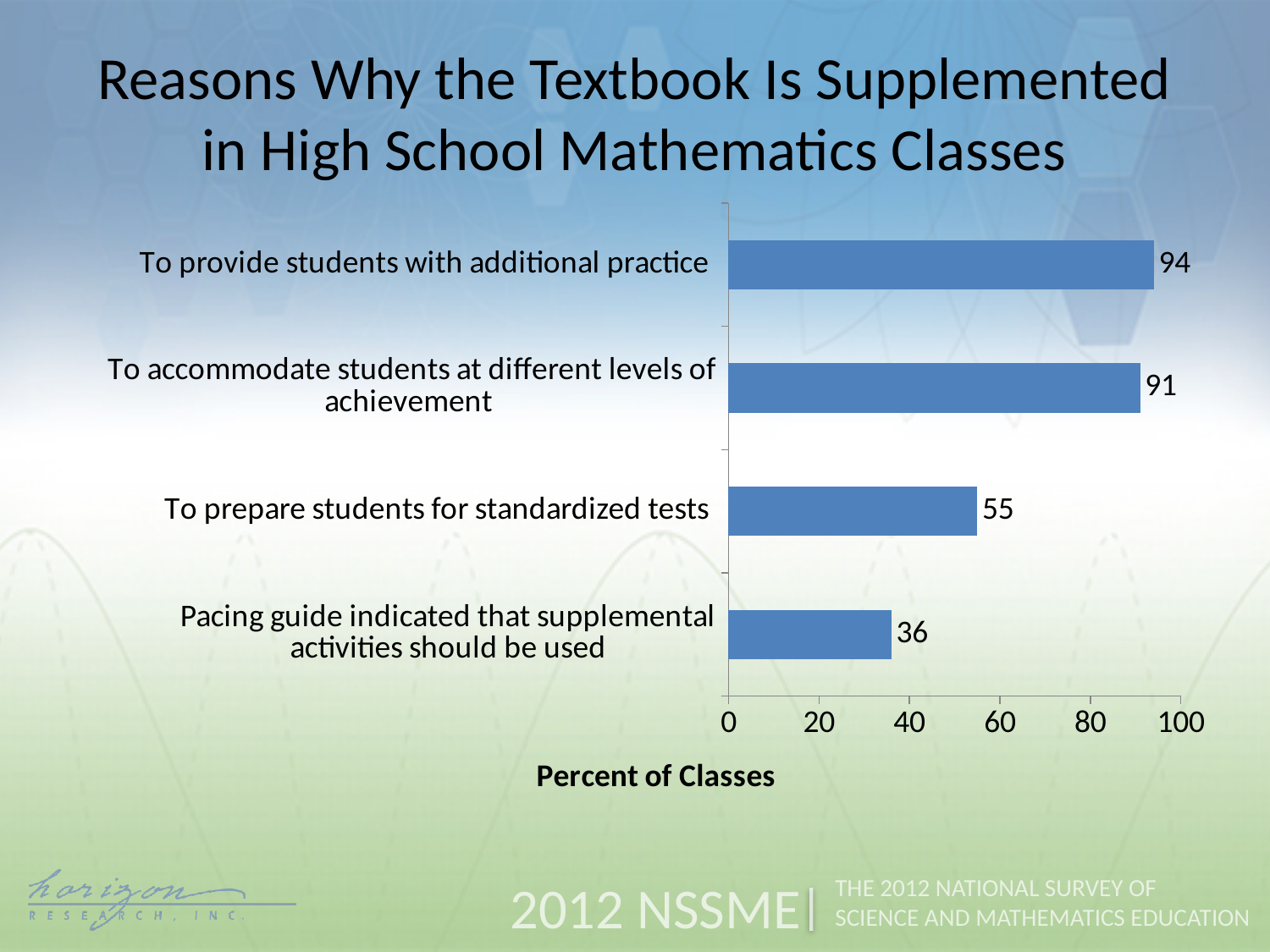
How many reasons are shown in the chart? 4 What kind of chart is shown on the slide? bar chart Is the value for 'To accommodate students at different levels of achievement' greater or less than 80? greater Which reason has the lowest percent of classes? Pacing guide indicated that supplemental activities should be used What is the label of the horizontal axis? Percent of Classes What is the value for 'To accommodate students at different levels of achievement'? 91 What percent of classes cite that the pacing guide indicated that supplemental activities should be used? 36 What is the value for 'To prepare students for standardized tests'? 55 Which reason has the highest percent of classes? To provide students with additional practice Which is larger: the value for 'To prepare students for standardized tests' or for 'Pacing guide indicated that supplemental activities should be used'? To prepare students for standardized tests What percent of classes supplement the textbook to provide students with additional practice? 94 What is the difference between the values for 'To provide students with additional practice' and 'To prepare students for standardized tests'? 39